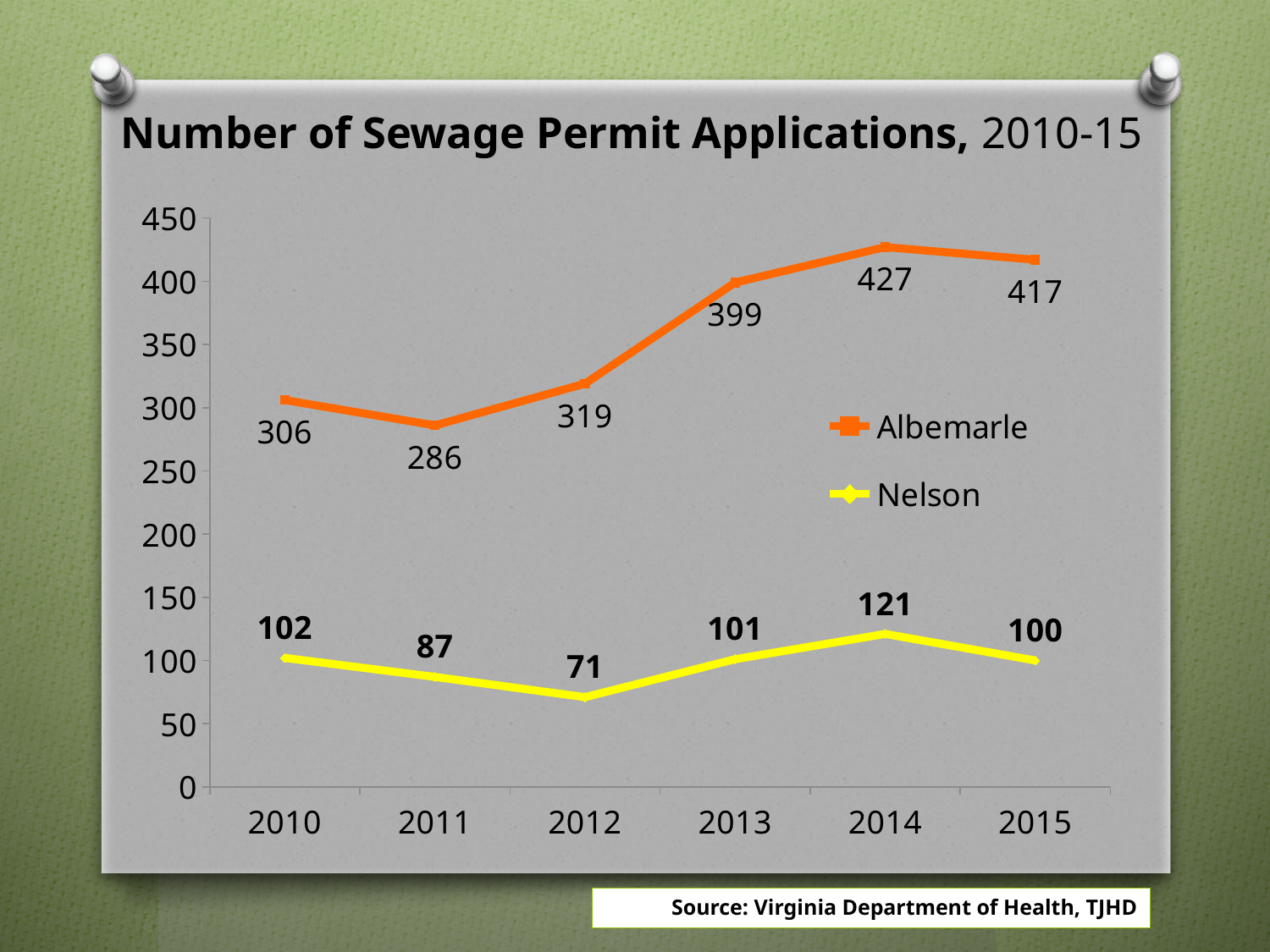
What kind of chart is shown on the slide? Line chart Did Albemarle's sewage permit applications rise or fall from 2011 to 2014? Rise What was the number of sewage permit applications for Albemarle in 2013? 399 In which year did Albemarle have the highest number of sewage permit applications? 2014 Is Albemarle's value for 2012 greater or less than 300? greater By how much did Albemarle's sewage permit applications change from 2010 to 2011? 20 In which year did Nelson have the lowest number of sewage permit applications? 2012 Which had more sewage permit applications in 2011, Albemarle or Nelson? Albemarle What was the number of sewage permit applications for Nelson in 2012? 71 How many years are shown on the x axis of the chart? 6 How many series does the legend list? 2 What is the difference between Albemarle's and Nelson's sewage permit applications in 2015? 317